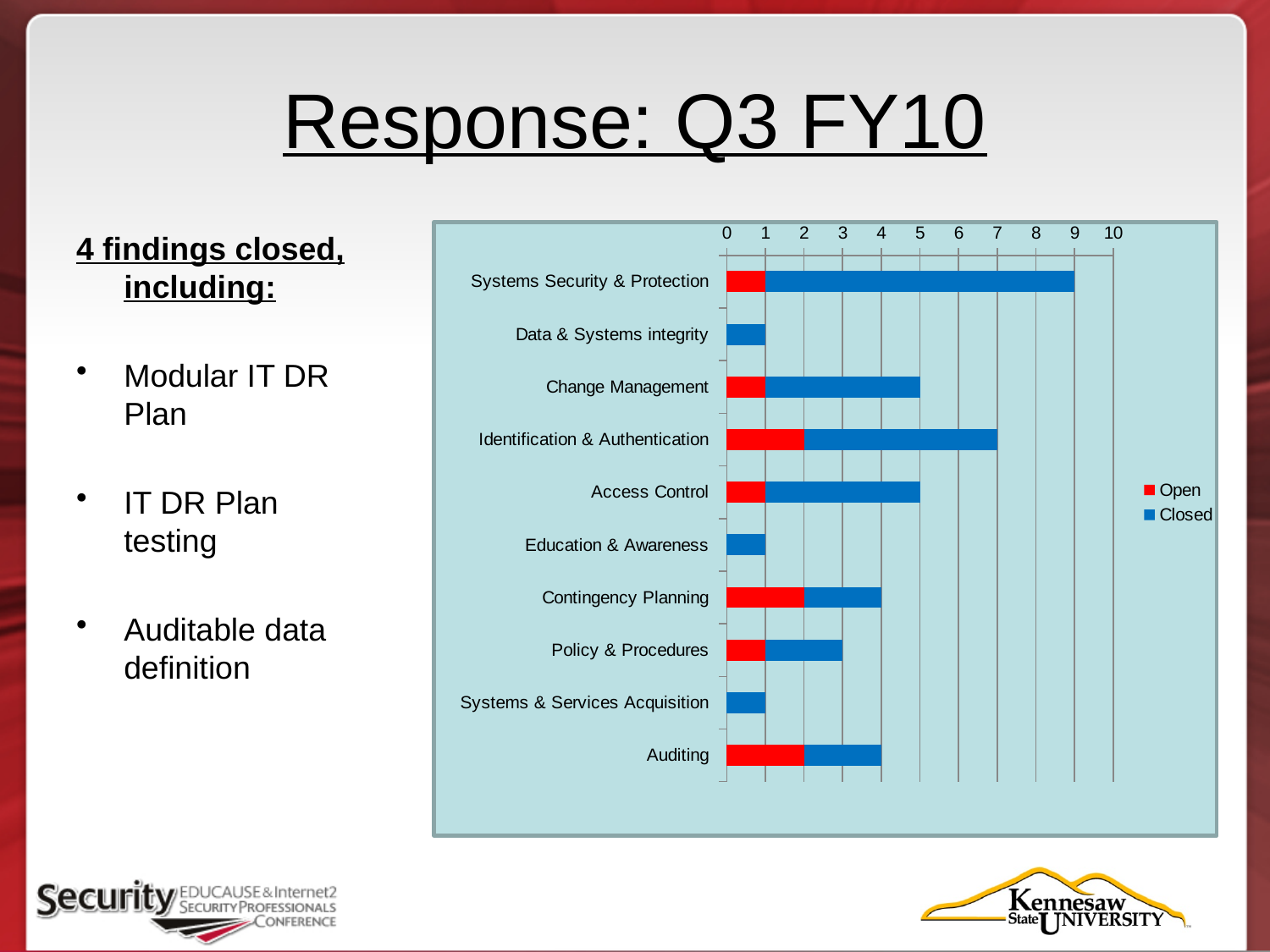
How many series does the legend list? 2 Is the total value for Contingency Planning greater or less than 5? less What kind of chart is shown on the slide? Stacked bar chart What is the difference between the total bar lengths of Systems Security & Protection and Auditing? 5 What is the Open value for Identification & Authentication? 2 What is the Open value for Policy & Procedures? 1 Is the total bar for Change Management longer or shorter than the total bar for Policy & Procedures? longer Which category has the longest total bar? Systems Security & Protection What are the two series named in the legend? Open and Closed What is the total bar length for Identification & Authentication? 7 What is the total bar length for Systems Security & Protection? 9 How many categories are plotted on the chart? 10